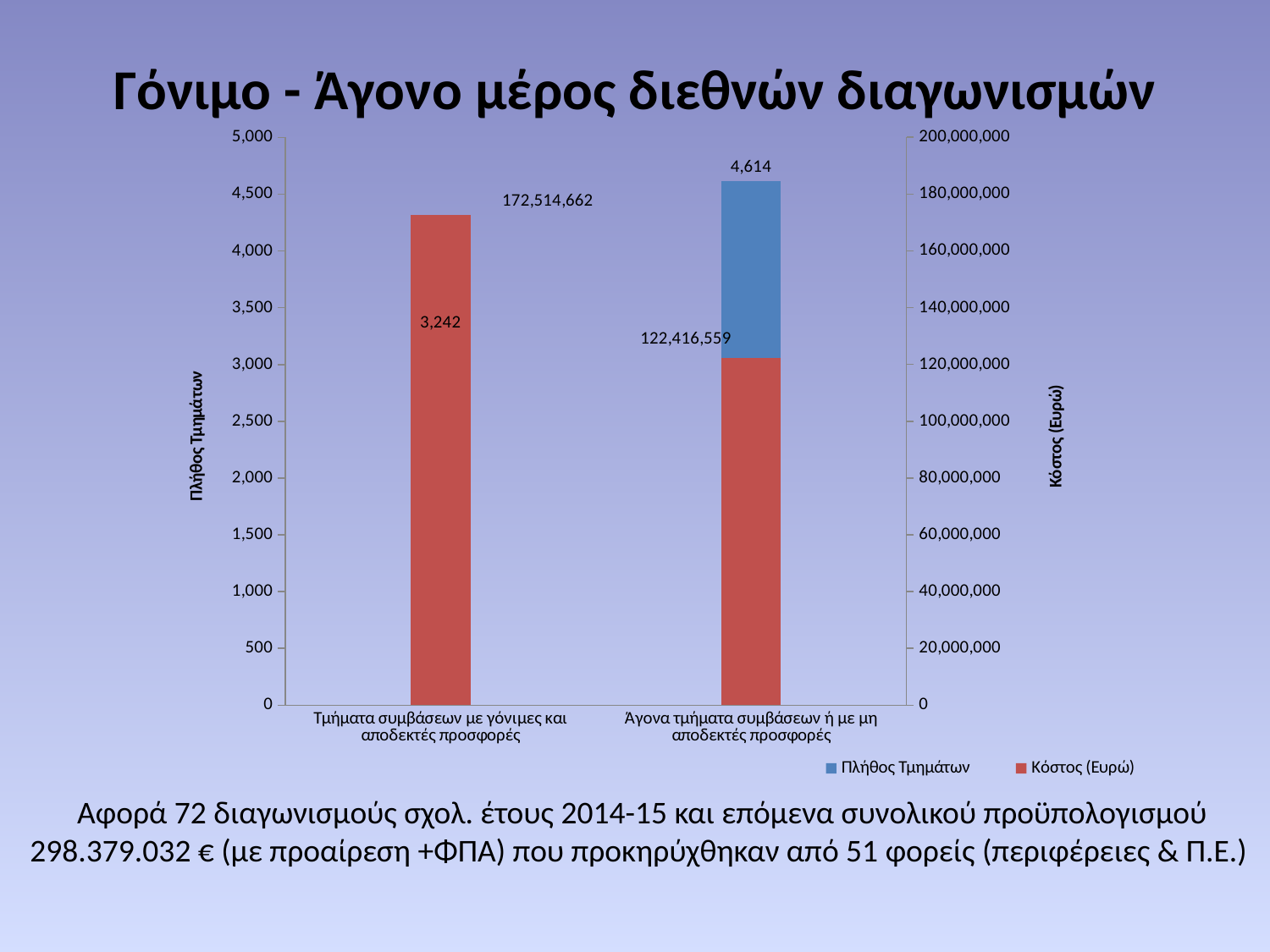
What is the value of Πλήθος Τμημάτων for 'Τμήματα συμβάσεων με γόνιμες και αποδεκτές προσφορές'? 3,242 Is the Πλήθος Τμημάτων for 'Άγονα τμήματα συμβάσεων ή με μη αποδεκτές προσφορές' greater or less than 4,000? greater What is the Κόστος (Ευρώ) for 'Άγονα τμήματα συμβάσεων ή με μη αποδεκτές προσφορές'? 122,416,559 Which category has the highest Κόστος (Ευρώ)? Τμήματα συμβάσεων με γόνιμες και αποδεκτές προσφορές What is the difference in Κόστος (Ευρώ) between the 'γόνιμες' category and the 'Άγονα' category? 50,098,103 What type of chart is shown on the slide? bar chart How many categories are shown on the x axis of the chart? 2 What is the Κόστος (Ευρώ) for 'Τμήματα συμβάσεων με γόνιμες και αποδεκτές προσφορές'? 172,514,662 How many series does the legend list? 2 Which category has the higher Πλήθος Τμημάτων? Άγονα τμήματα συμβάσεων ή με μη αποδεκτές προσφορές What is the difference in Πλήθος Τμημάτων between the 'Άγονα' category and the 'γόνιμες' category? 1,372 What is the value of Πλήθος Τμημάτων for 'Άγονα τμήματα συμβάσεων ή με μη αποδεκτές προσφορές'? 4,614